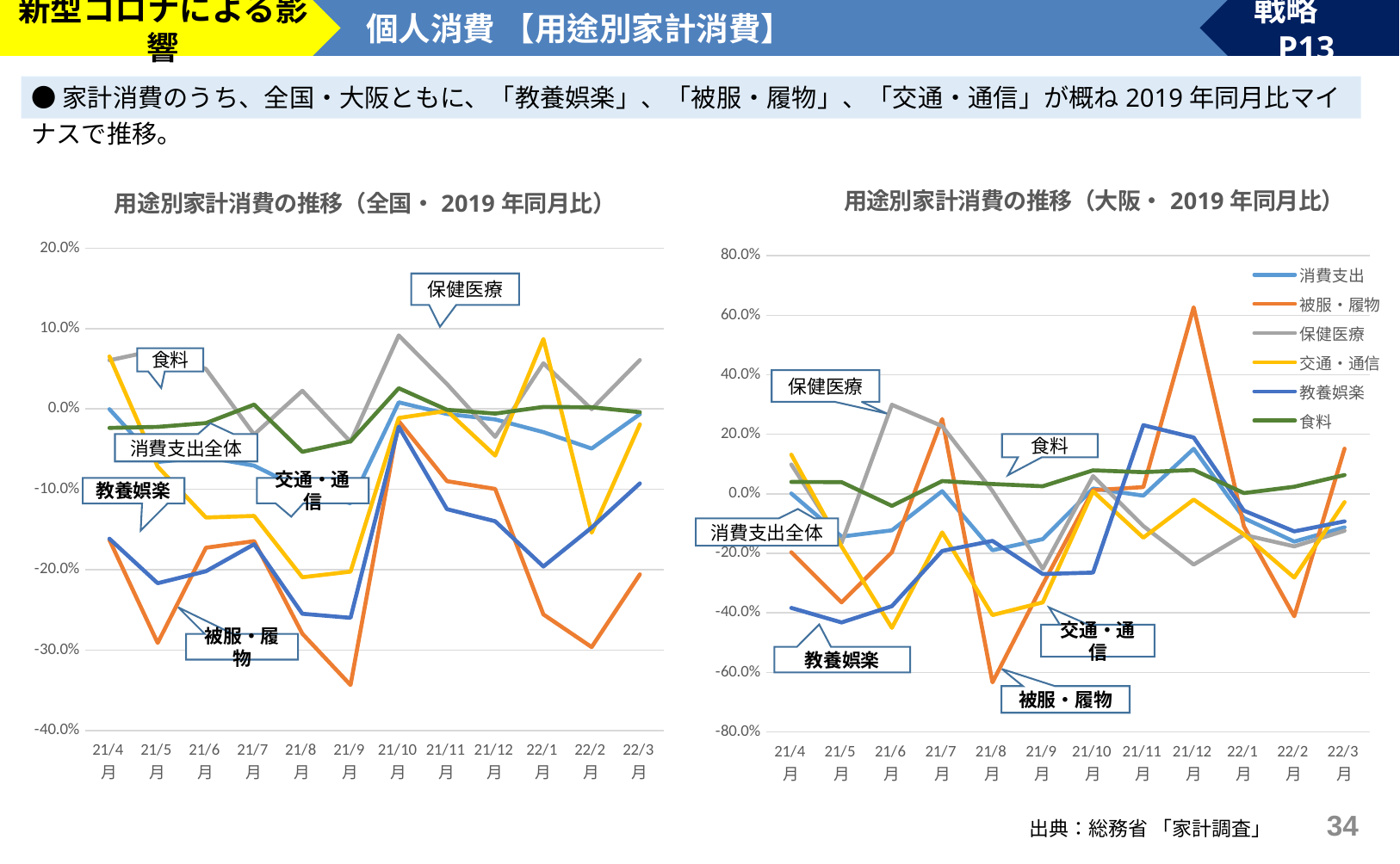
How many series does the legend of the right chart (大阪) list? 6 In the right chart (大阪), is the value for 被服・履物 at 21/12月 greater or less than 60.0%? greater In the left chart (全国), is the value for 被服・履物 at 21/9月 greater or less than -30.0%? less What kind of chart is the left chart titled 用途別家計消費の推移（全国・2019年同月比）? line chart What source is cited at the bottom of the slide for the charts? 総務省「家計調査」 How many months are plotted along the x axis of the left chart (全国)? 12 In the right chart (大阪), which series reaches the highest value on the chart? 被服・履物 In the left chart (全国), which series has the lowest value at 21/9月? 被服・履物 In the left chart (全国), at 21/9月, which is larger: 教養娯楽 or 交通・通信? 交通・通信 In the right chart (大阪), does the 被服・履物 line rise or fall from 21/12月 to 22/2月? fall In the right chart (大阪), at 21/6月, which is larger: 保健医療 or 食料? 保健医療 In the right chart (大阪), is the value for 被服・履物 at 21/8月 greater or less than -60.0%? less